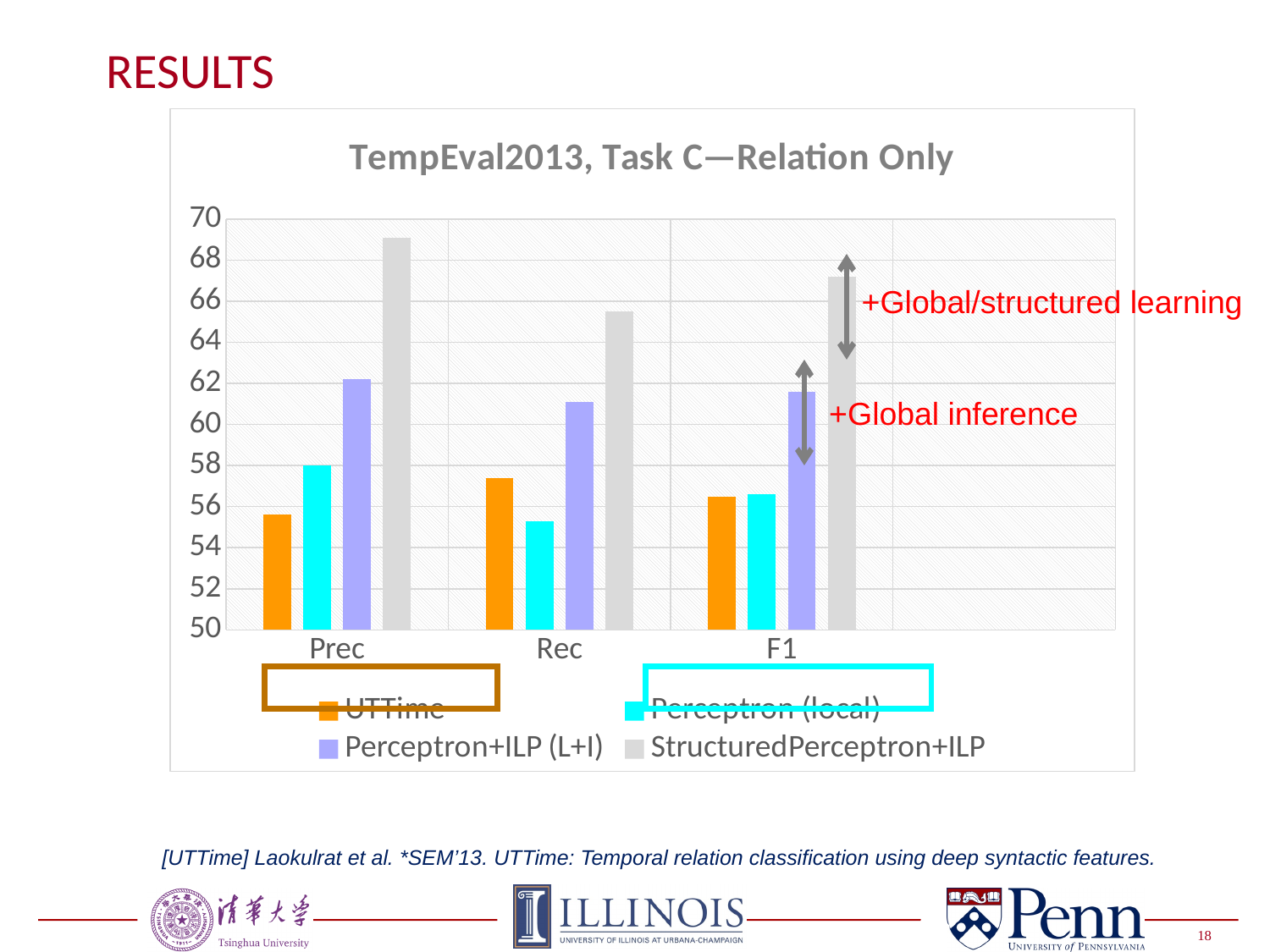
For StructuredPerceptron+ILP, which is larger: the Prec value or the Rec value? Prec How many series does the chart's legend list? 4 Which series has the lowest value for Prec? UTTime How many categories are shown on the x axis of the chart? 3 What is the title of the chart? TempEval2013, Task C—Relation Only Is the Prec value for StructuredPerceptron+ILP greater or less than 66? greater For Rec, which is larger: the value for UTTime or the value for Perceptron (local)? UTTime Which series has the highest value for Prec? StructuredPerceptron+ILP Is the F1 value for Perceptron+ILP (L+I) greater or less than 60? greater Which series has the lowest value for Rec? Perceptron (local) What kind of chart is shown on the slide? bar chart Which series has the highest value for F1? StructuredPerceptron+ILP